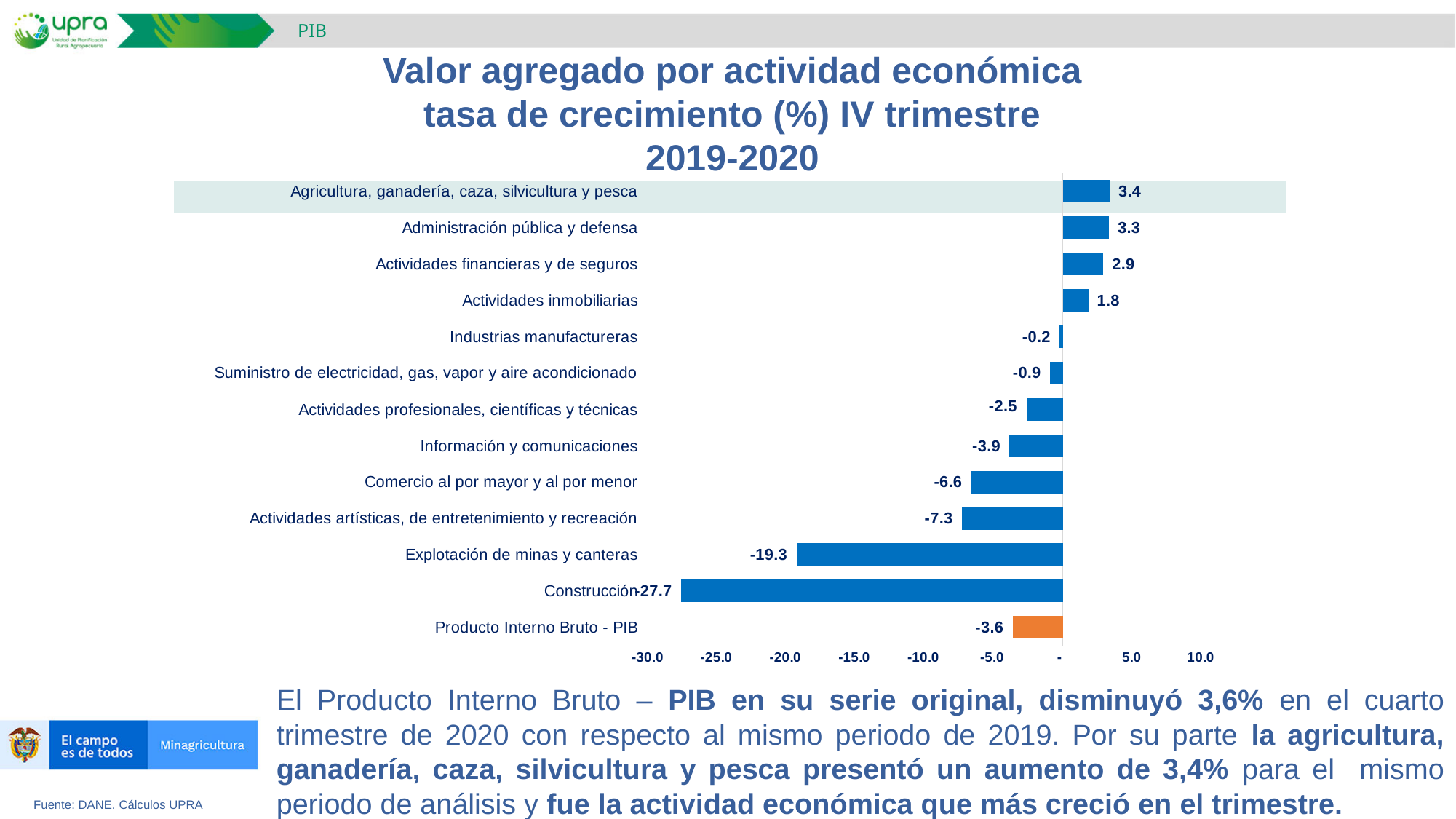
What is the growth rate for Construcción? -27.7 Which activity has the lowest growth rate? Construcción Which has a larger growth rate, Actividades financieras y de seguros or Actividades inmobiliarias? Actividades financieras y de seguros Is the value for Comercio al por mayor y al por menor greater or less than -5.0? less What is the growth rate for Explotación de minas y canteras? -19.3 How many categories are shown on the chart? 13 What is the growth rate for Agricultura, ganadería, caza, silvicultura y pesca? 3.4 Which activity has the highest growth rate? Agricultura, ganadería, caza, silvicultura y pesca What is the value shown for Producto Interno Bruto - PIB? -3.6 What kind of chart is shown on the slide? Bar chart Which bar is shown in orange rather than blue? Producto Interno Bruto - PIB What is the difference between the growth rates of Agricultura, ganadería, caza, silvicultura y pesca and Administración pública y defensa? 0.1